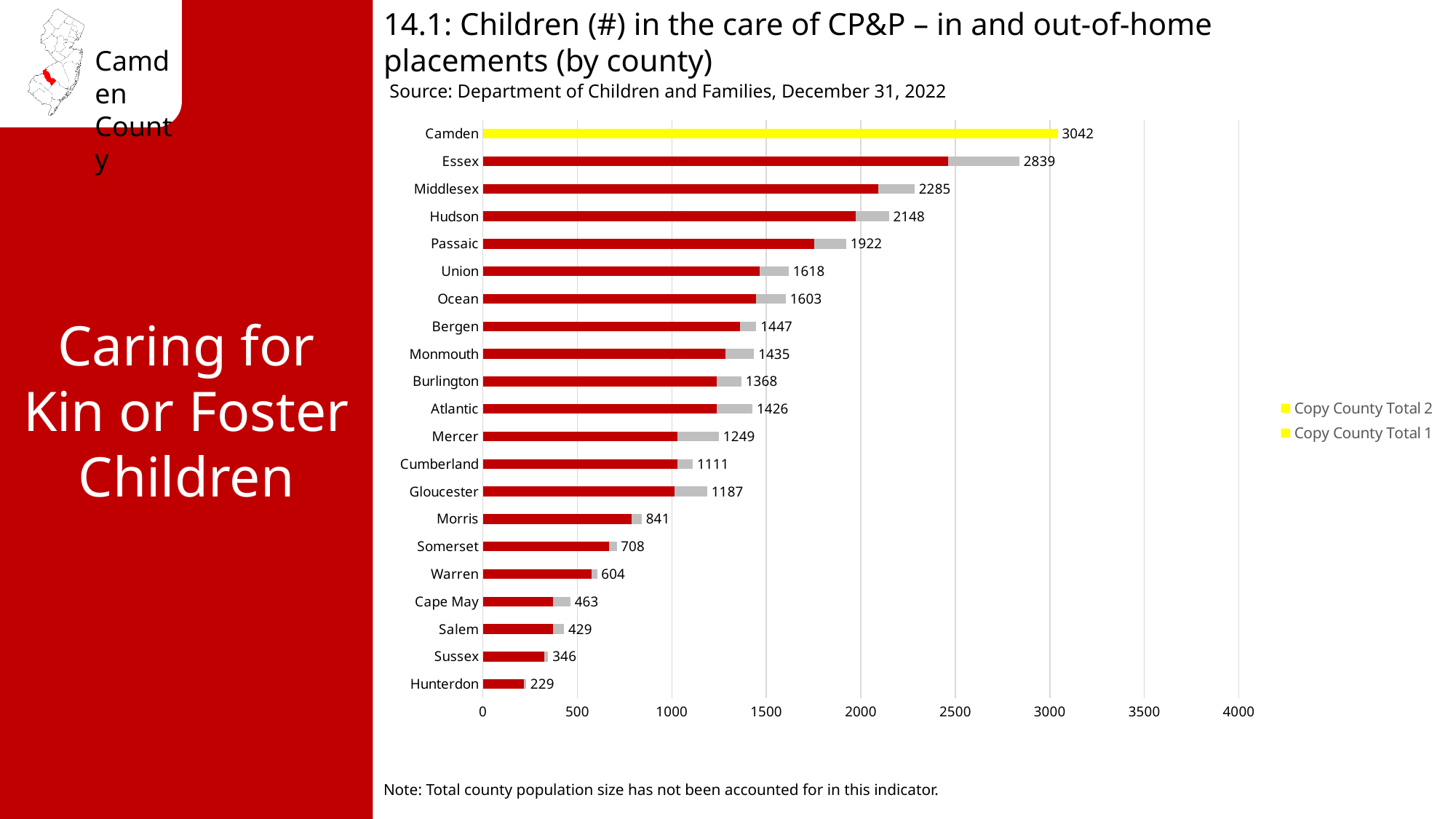
What kind of chart is shown on the slide? bar chart What is the total number of children in the care of CP&P shown for Camden? 3042 Is the total for Passaic greater or less than 2000? less How many counties are shown on the chart? 21 What is the difference between the totals for Camden and Essex? 203 How many series does the legend list? 2 What colour is the bar for Camden? yellow Which county has the lowest total shown on the chart? Hunterdon What value is labeled for Essex? 2839 Which county has the highest total shown on the chart? Camden Which has a larger total, Atlantic or Burlington? Atlantic What value is labeled for Gloucester? 1187